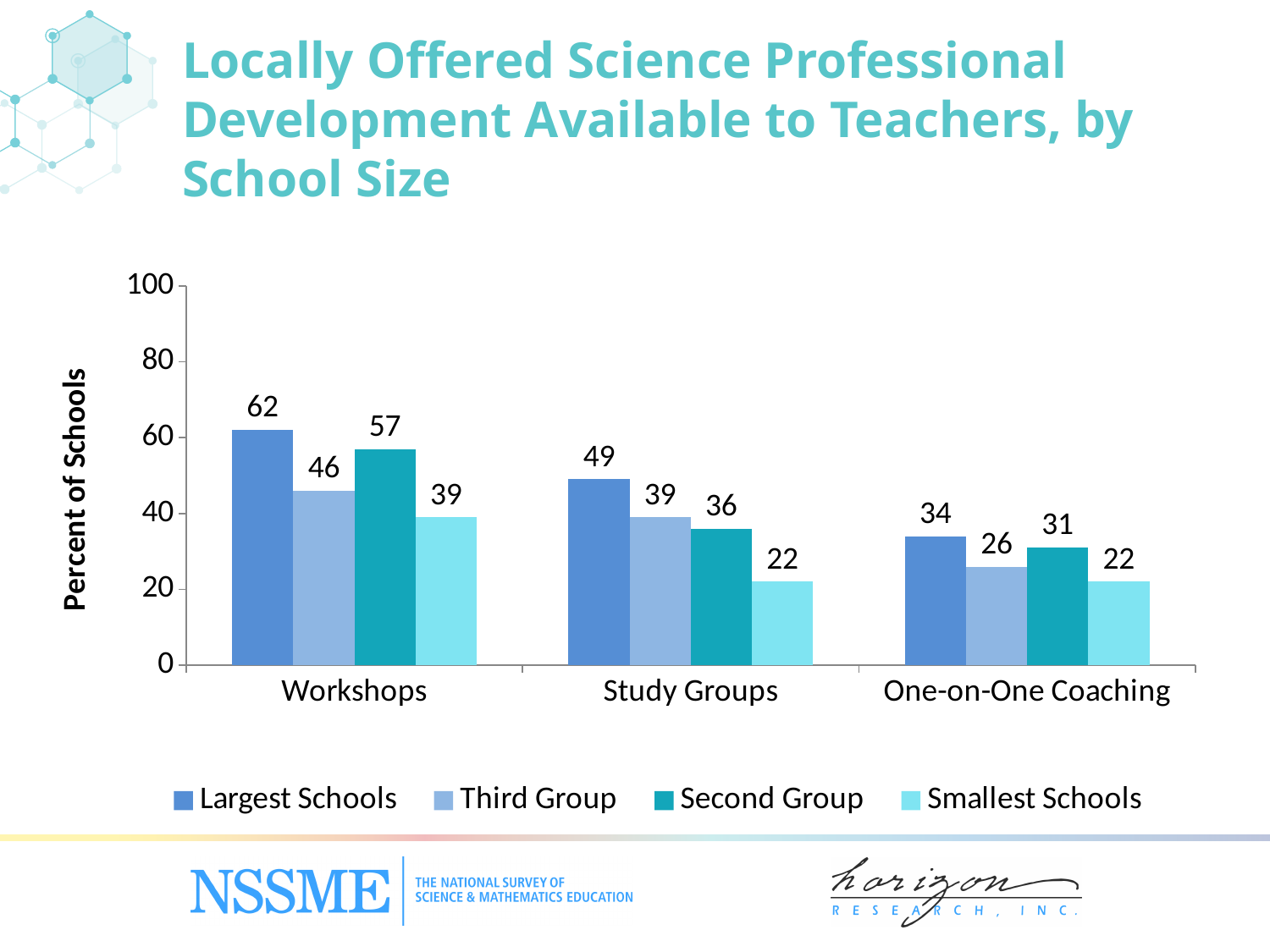
How many series does the legend list? 4 How many professional development categories are shown on the x axis? 3 What percent of the largest schools offer workshops? 62 Is the value for Largest Schools in Study Groups greater or less than 40? greater Which school size group has the lowest value for One-on-One Coaching? Smallest Schools Which is larger for Study Groups: the Third Group value or the Second Group value? Third Group What is the value for Second Group in the One-on-One Coaching category? 31 What kind of chart is shown on the slide? Bar chart What is the label of the y axis? Percent of Schools What is the value for Smallest Schools in the Study Groups category? 22 What is the difference between the Largest Schools and Smallest Schools values for Workshops? 23 Which school size group has the highest value for Workshops? Largest Schools